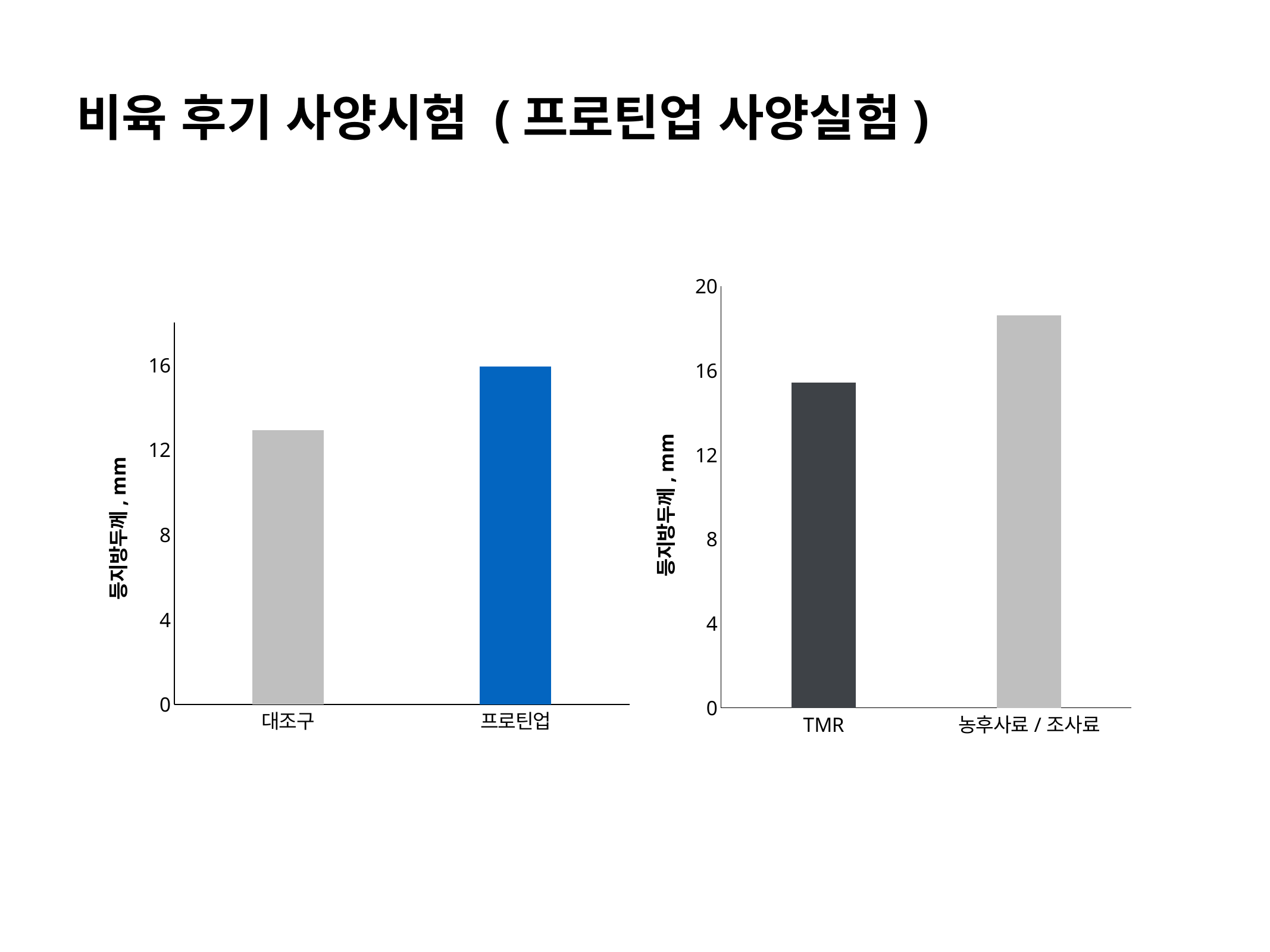
In the right chart, which is larger, the value for TMR or the value for 농후사료 / 조사료? 농후사료 / 조사료 In the right chart, which category has the highest value? 농후사료 / 조사료 In the left chart, is the value for 대조구 greater or less than 12? greater How many categories does the left chart show? 2 How many categories does the right chart show? 2 In the right chart, is the value for TMR greater or less than 16? less In the left chart, which category has the lowest value? 대조구 In the right chart, which category has the lowest value? TMR In the right chart, is the value for 농후사료 / 조사료 greater or less than 16? greater What is the y-axis label of the left chart? 등지방두께 , mm What kind of chart is the left chart on the slide? bar chart In the left chart, which category has the highest value? 프로틴업